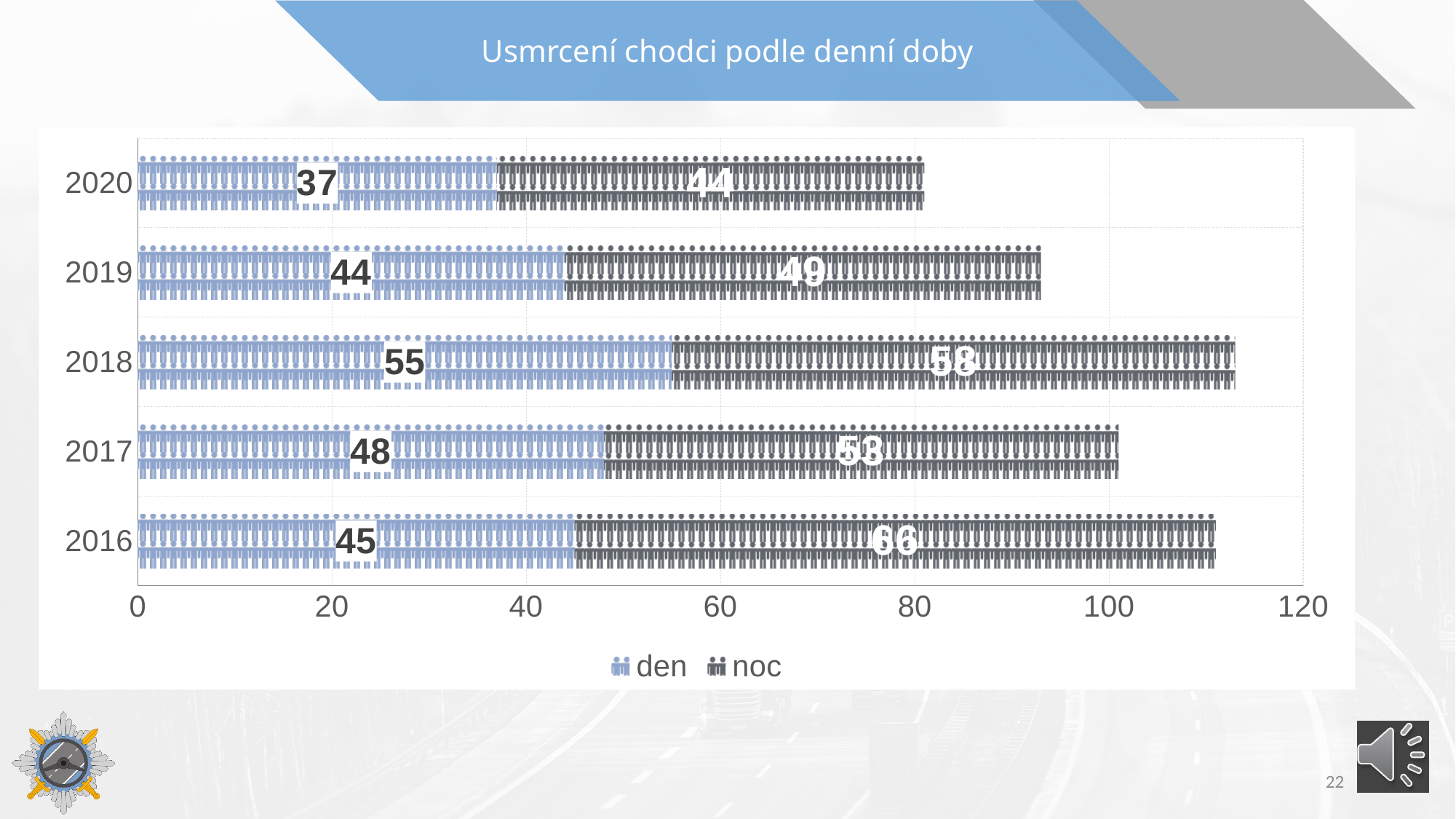
How many years are shown on the chart? 5 How many series does the legend list? 2 Which is larger in 2019: the 'den' value or the 'noc' value? noc What is the value for 'den' in 2020? 37 Is the total of the stacked bar for 2020 greater or less than 100? less Which year has the lowest 'den' value? 2020 What is the title of the chart? Usmrcení chodci podle denní doby What is the total of the stacked bar for 2018? 113 What type of chart is shown on the slide? stacked bar chart What is the value for 'noc' in 2016? 66 Which year has the highest 'noc' value? 2016 What is the difference between the 'noc' and 'den' values in 2016? 21